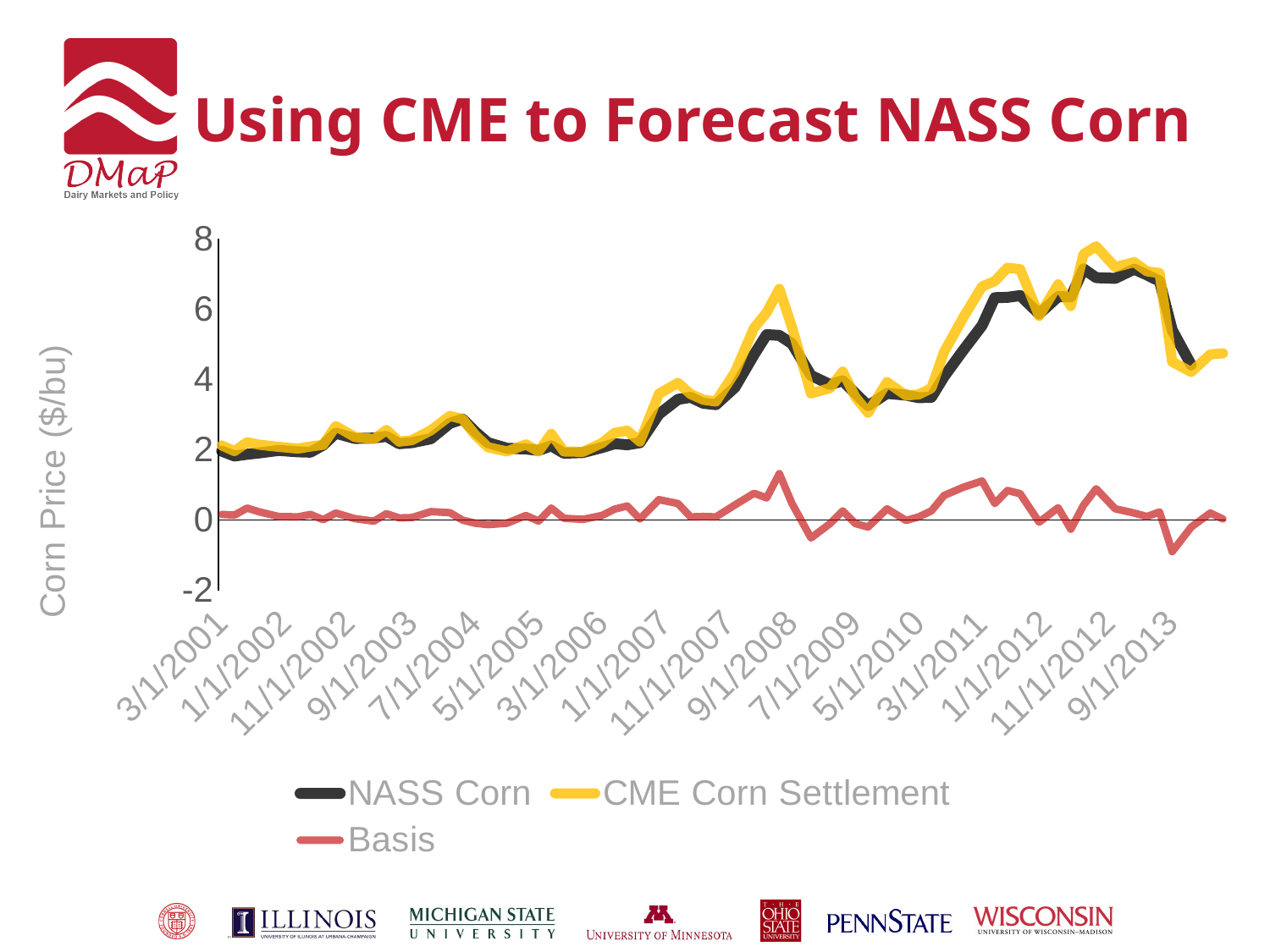
What is the label on the vertical axis? Corn Price ($/bu) Is the value of NASS Corn around 9/1/2008 greater or less than 4? greater Is the value of Basis around 9/1/2008 greater or less than 2? less How many series does the legend list? 3 Around 9/1/2008, which is higher: NASS Corn or CME Corn Settlement? CME Corn Settlement Which series reaches the highest value on the chart? CME Corn Settlement What is the title of the slide's chart? Using CME to Forecast NASS Corn Is the value of CME Corn Settlement around 11/1/2012 greater or less than 6? greater Which series has the lowest values on the chart? Basis What kind of chart is shown on the slide? line chart Does NASS Corn generally rise or fall from 3/1/2001 to 11/1/2012? rise